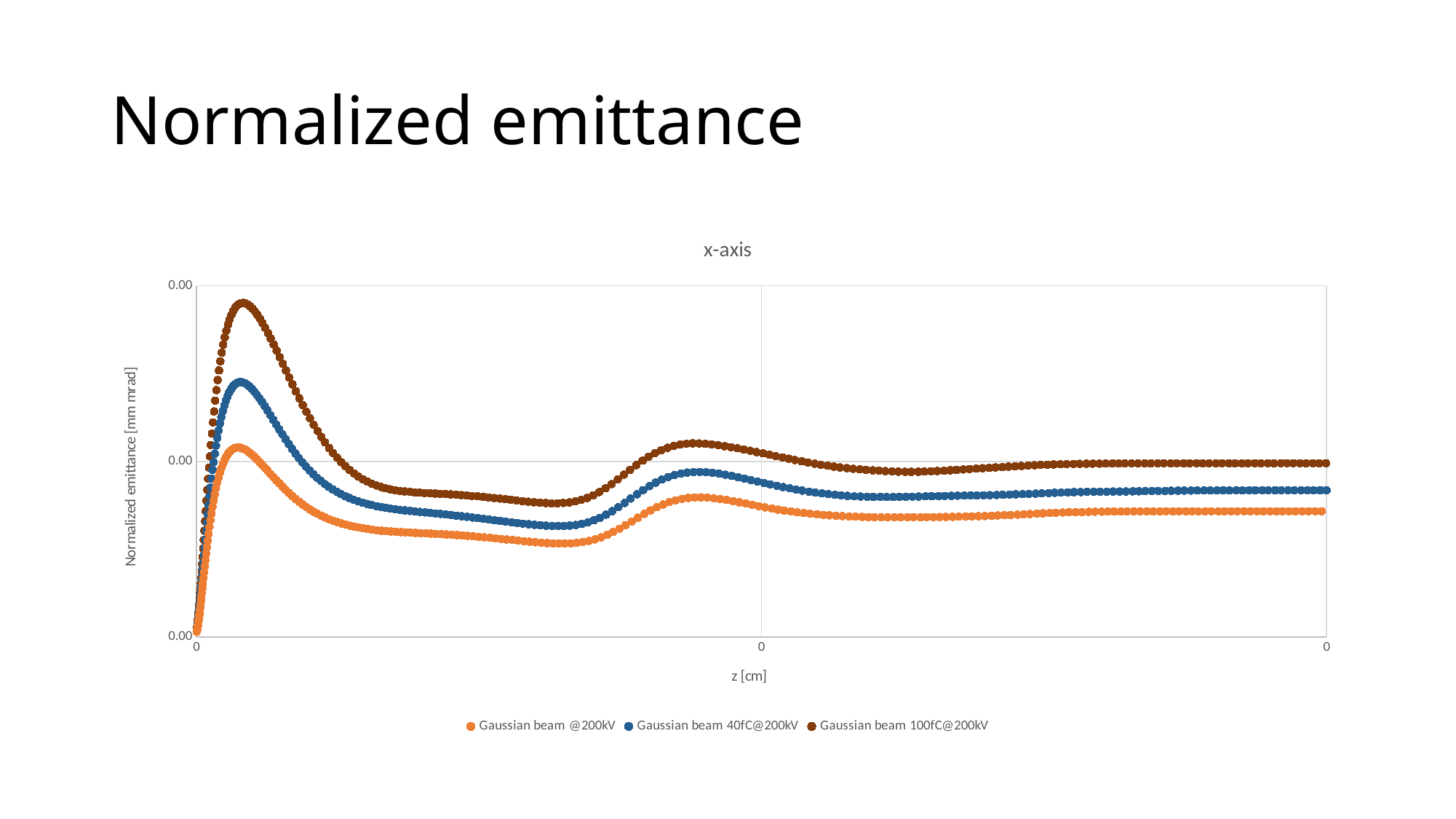
Immediately after the first peak, do the values rise or fall along the x axis? fall What is the label on the vertical axis? Normalized emittance [mm mrad] At the first peak, which is higher: Gaussian beam 40fC@200kV or Gaussian beam 100fC@200kV? Gaussian beam 100fC@200kV Near the start of the x axis, do the values rise or fall? rise How many distinct peaks does each curve show? 2 What kind of chart is shown on the slide? scatter chart Which series has the lowest values across the chart? Gaussian beam @200kV In the right half of the chart, do the curves keep oscillating strongly or level off? level off Which series reaches the highest peak? Gaussian beam 100fC@200kV How many series does the legend list? 3 At the right end of the chart, which is higher: Gaussian beam @200kV or Gaussian beam 40fC@200kV? Gaussian beam 40fC@200kV What is the title of the chart? x-axis